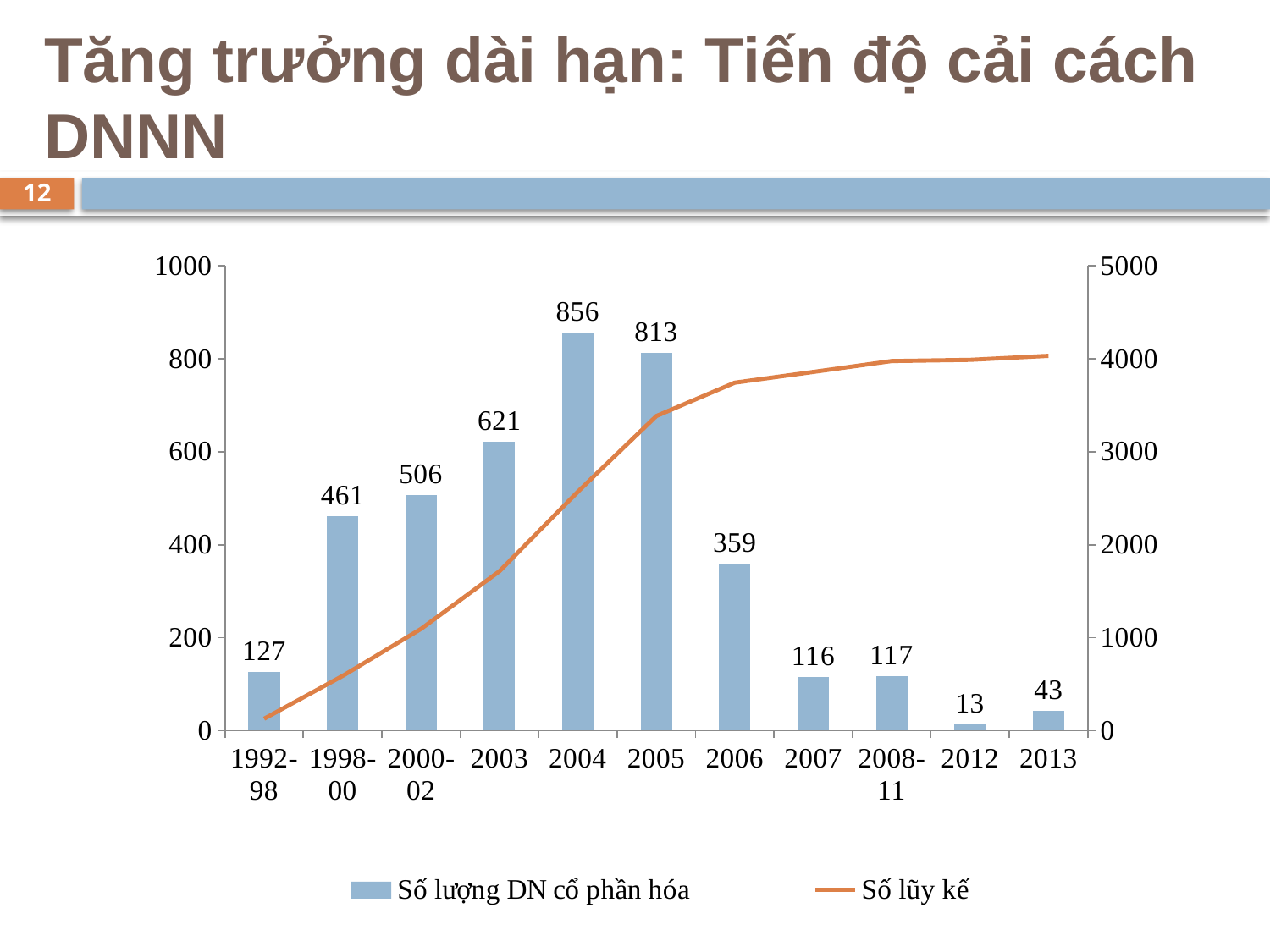
Which has a larger Số lượng DN cổ phần hóa value, 2003 or 2006? 2003 Is the Số lũy kế value for 2006 greater or less than 3000? greater Does the Số lũy kế line rise or fall from 1992-98 to 2013? rise What is the value of Số lượng DN cổ phần hóa for 2008-11? 117 How many series does the legend list? 2 What is the difference between the Số lượng DN cổ phần hóa values for 2004 and 2005? 43 What is the value of Số lượng DN cổ phần hóa for 1992-98? 127 What is the value of Số lượng DN cổ phần hóa for 2004? 856 Which period has the lowest value of Số lượng DN cổ phần hóa? 2012 Is the Số lũy kế value for 2003 greater or less than 2000? less Which period has the highest value of Số lượng DN cổ phần hóa? 2004 How many periods are shown on the x axis? 11